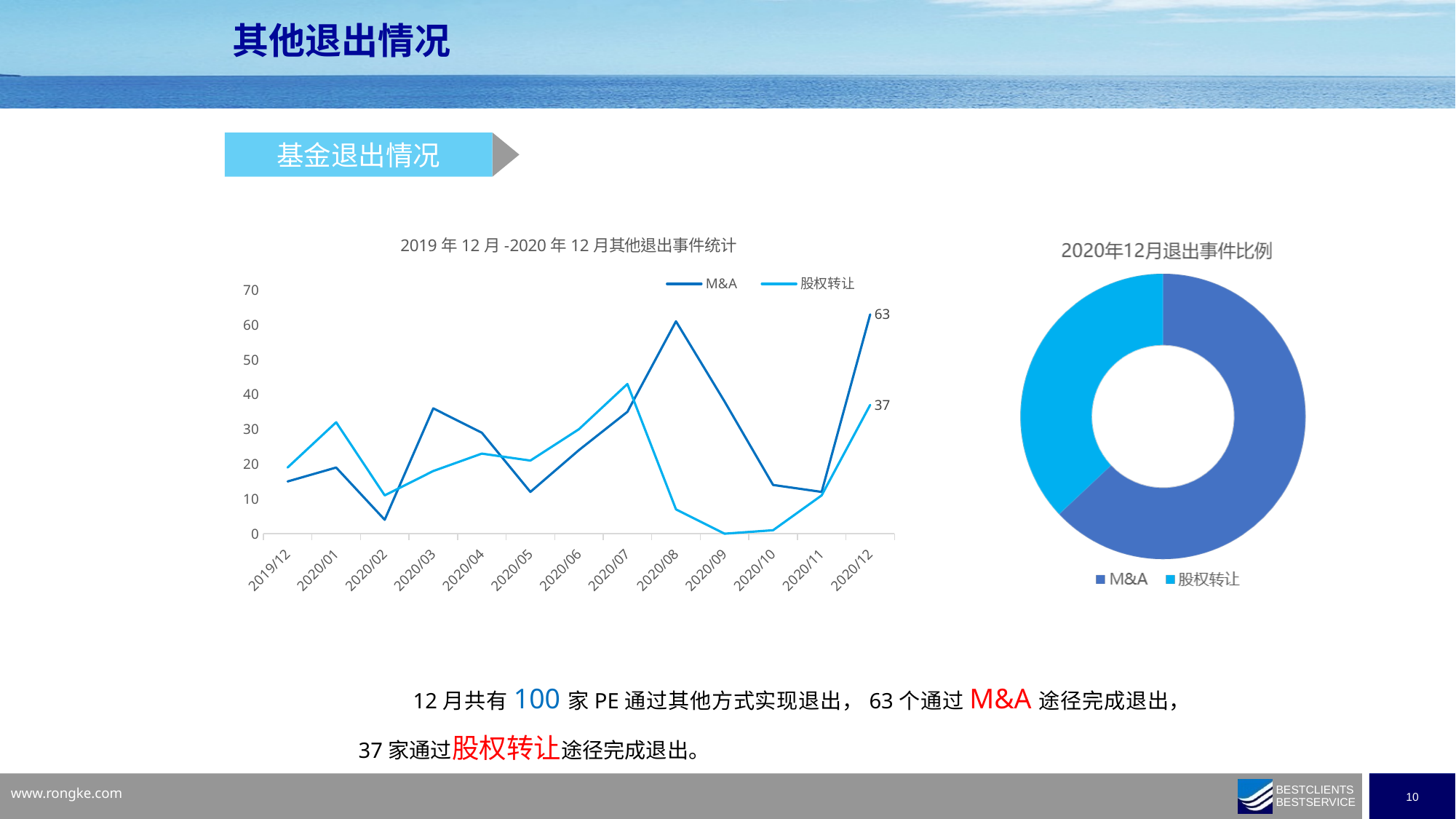
In the line chart titled 2019年12月-2020年12月其他退出事件统计, what is the value of M&A at 2020/12? 63 In the line chart on the left, which series has the larger value at 2020/12, M&A or 股权转让? M&A In the line chart on the left, is the value for 股权转让 at 2020/09 greater or less than 10? less In the line chart on the left, at which month is the M&A series at its lowest? 2020/02 In the line chart titled 2019年12月-2020年12月其他退出事件统计, what is the value of 股权转让 at 2020/12? 37 How many series does the legend of the line chart on the left list? 2 What kind of chart is the chart titled 2020年12月退出事件比例 on the right? Donut chart In the line chart on the left, at which month is the 股权转让 series at its lowest? 2020/09 In the line chart on the left, is the value for M&A at 2020/08 greater or less than 50? greater How many months are plotted along the x axis of the line chart on the left? 13 In the donut chart titled 2020年12月退出事件比例, which category has the larger slice, M&A or 股权转让? M&A In the line chart on the left, what is the difference between M&A and 股权转让 at 2020/12? 26